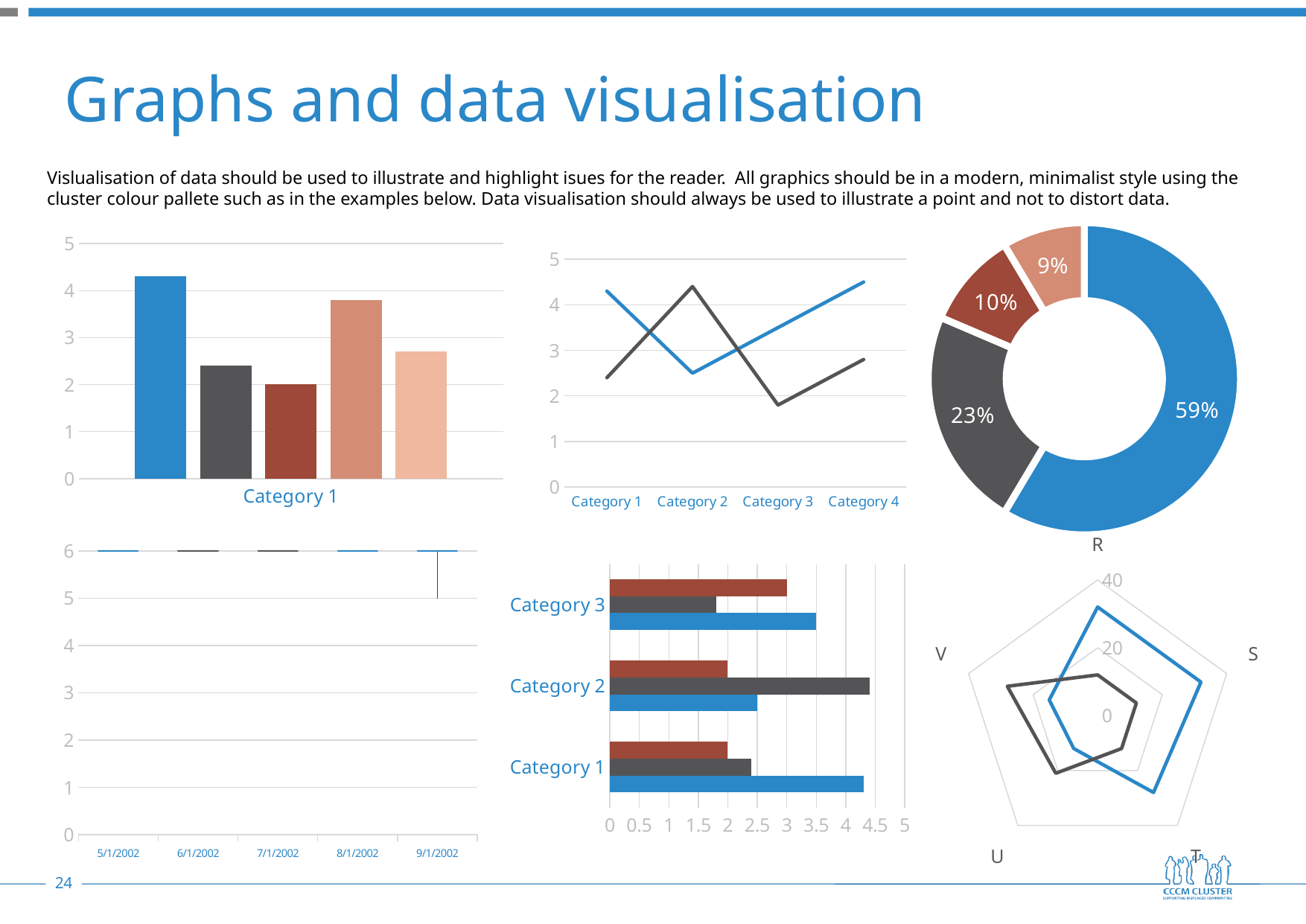
How many categories are shown on the x axis of the line chart at the top middle? 4 In the doughnut chart at the top right, what is the value of the largest slice? 59% In the vertical bar chart at the top left, is the value of the first (blue) bar greater or less than 4? greater In the vertical bar chart at the top left, is the value of the third (dark red) bar greater or less than 3? less How many slices does the doughnut chart at the top right have? 4 In the horizontal bar chart at the bottom middle, is the blue bar for Category 1 greater or less than 4? greater In the doughnut chart at the top right, what is the difference between the 59% slice and the 23% slice? 36 percentage points How many dates are shown on the x axis of the chart at the bottom left? 5 In the line chart at the top middle, which line is higher at Category 2, the blue line or the dark grey line? the dark grey line What kind of chart is shown at the top right of the slide? Doughnut (pie) chart In the doughnut chart at the top right, what is the value of the smallest slice? 9%